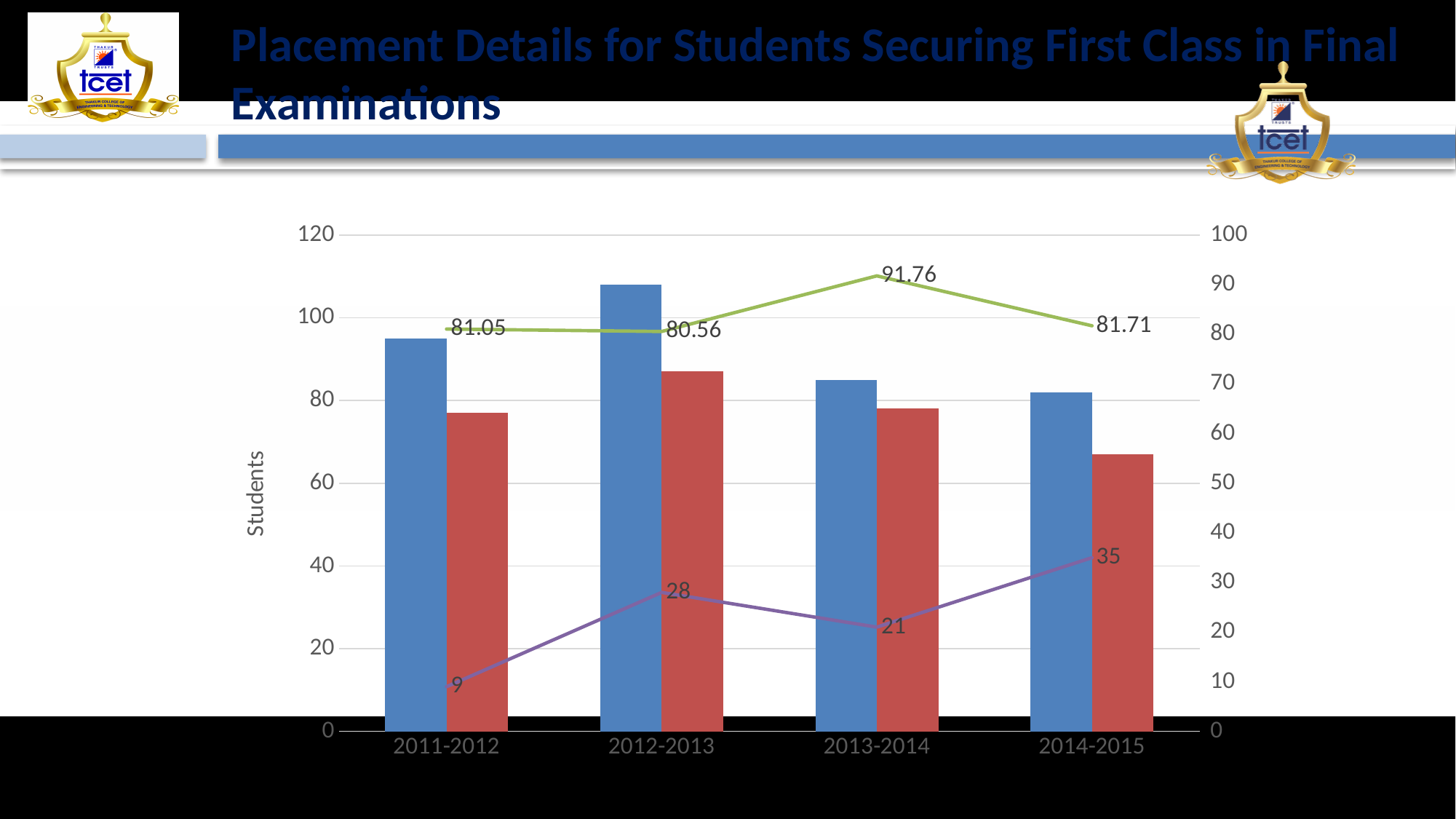
Is the red bar for 2014-2015 greater or less than 80 on the left axis? less What value does the green line show for 2013-2014? 91.76 What value does the green line show for 2012-2013? 80.56 In which year is the blue bar tallest? 2012-2013 Which is larger on the green line: the value for 2011-2012 or the value for 2014-2015? 2014-2015 Is the blue bar for 2012-2013 greater or less than 100 on the left axis? greater In which year does the purple line have its lowest value? 2011-2012 What is the title of the left vertical axis? Students What is the difference between the purple line's values for 2014-2015 and 2012-2013? 7 How many year categories are shown on the x axis? 4 In which year does the green line reach its highest value? 2013-2014 What value does the purple line show for 2011-2012? 9